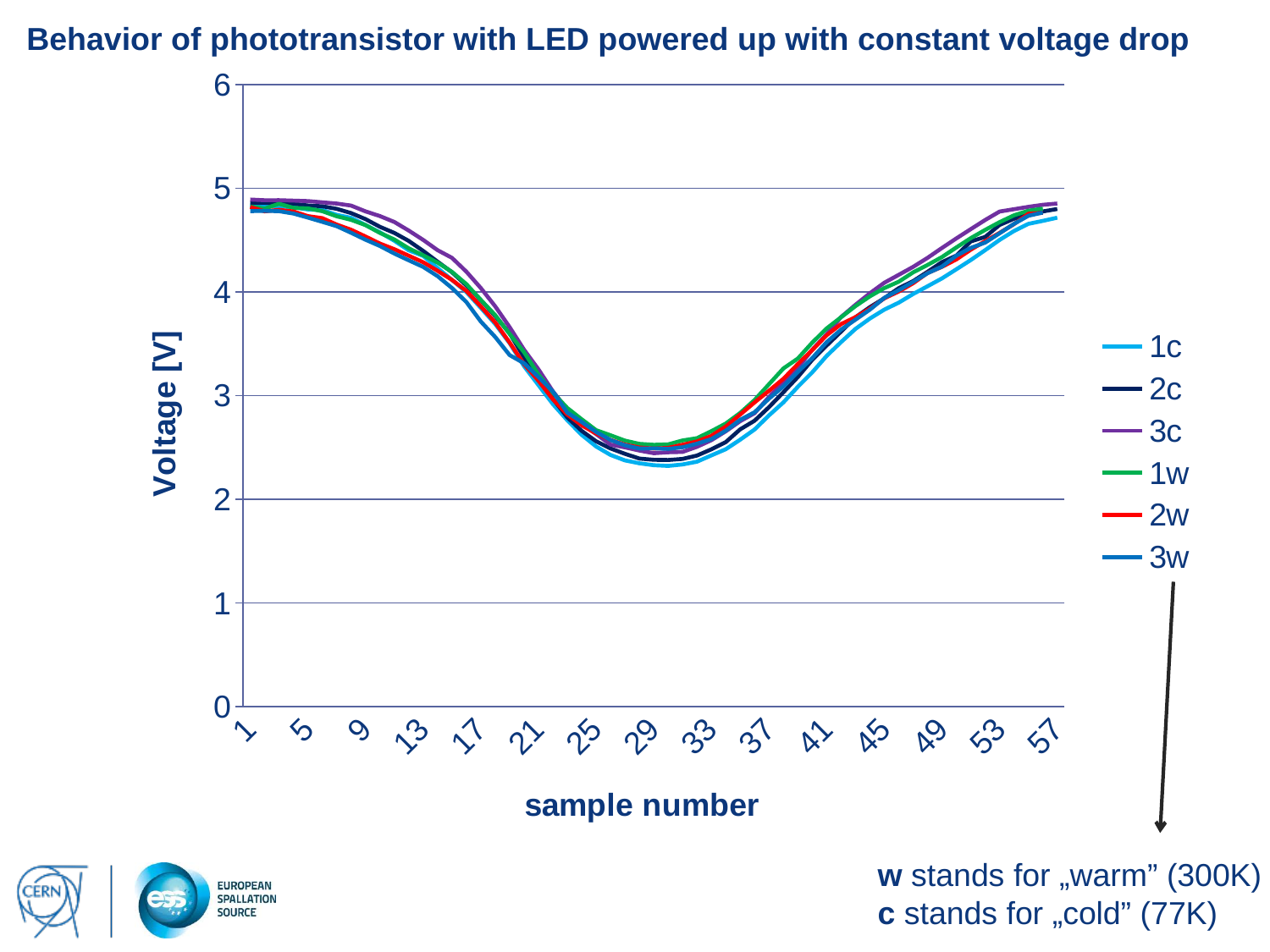
Is the value of series 1c at sample number 29 greater or less than 3? less What is the title of the chart? Behavior of phototransistor with LED powered up with constant voltage drop Is the value of series 1w at sample number 29 greater or less than 2? greater What is the label of the y axis? Voltage [V] Do the values of series 3w rise or fall from sample number 29 to sample number 57? rise Is the value of series 3c at sample number 1 greater or less than 4? greater What is the highest sample number labeled on the x axis? 57 What kind of chart is shown on the slide? line chart What is the maximum value shown on the y axis? 6 Do the values of series 2c rise or fall from sample number 1 to sample number 29? fall How many series does the legend list? 6